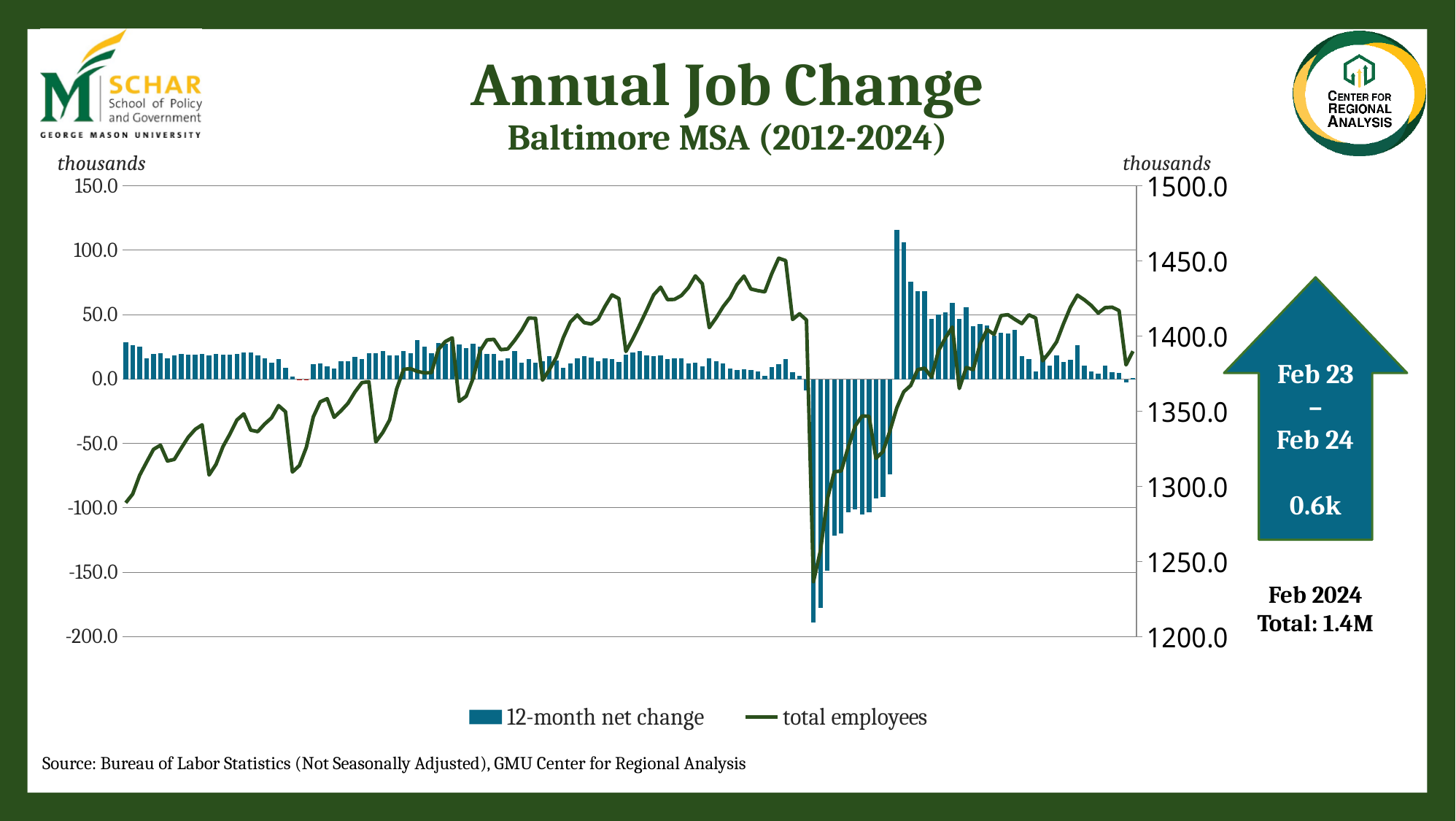
What is the title of the chart? Annual Job Change, Baltimore MSA (2012-2024) What kind of chart is shown on the slide? A combined bar and line chart What is the total employment for Feb 2024 shown on the slide? 1.4M What are the two series named in the chart legend? 12-month net change and total employees What is the job change from Feb 23 to Feb 24 shown in the callout arrow? 0.6k Does the total employees line end higher or lower than where it starts? higher Is the lowest value of the 12-month net change bars greater or less than -150.0? less Is the lowest point of the total employees line greater or less than 1250.0? less Is the first point of the total employees line greater or less than 1300.0? less How many series does the chart legend list? 2